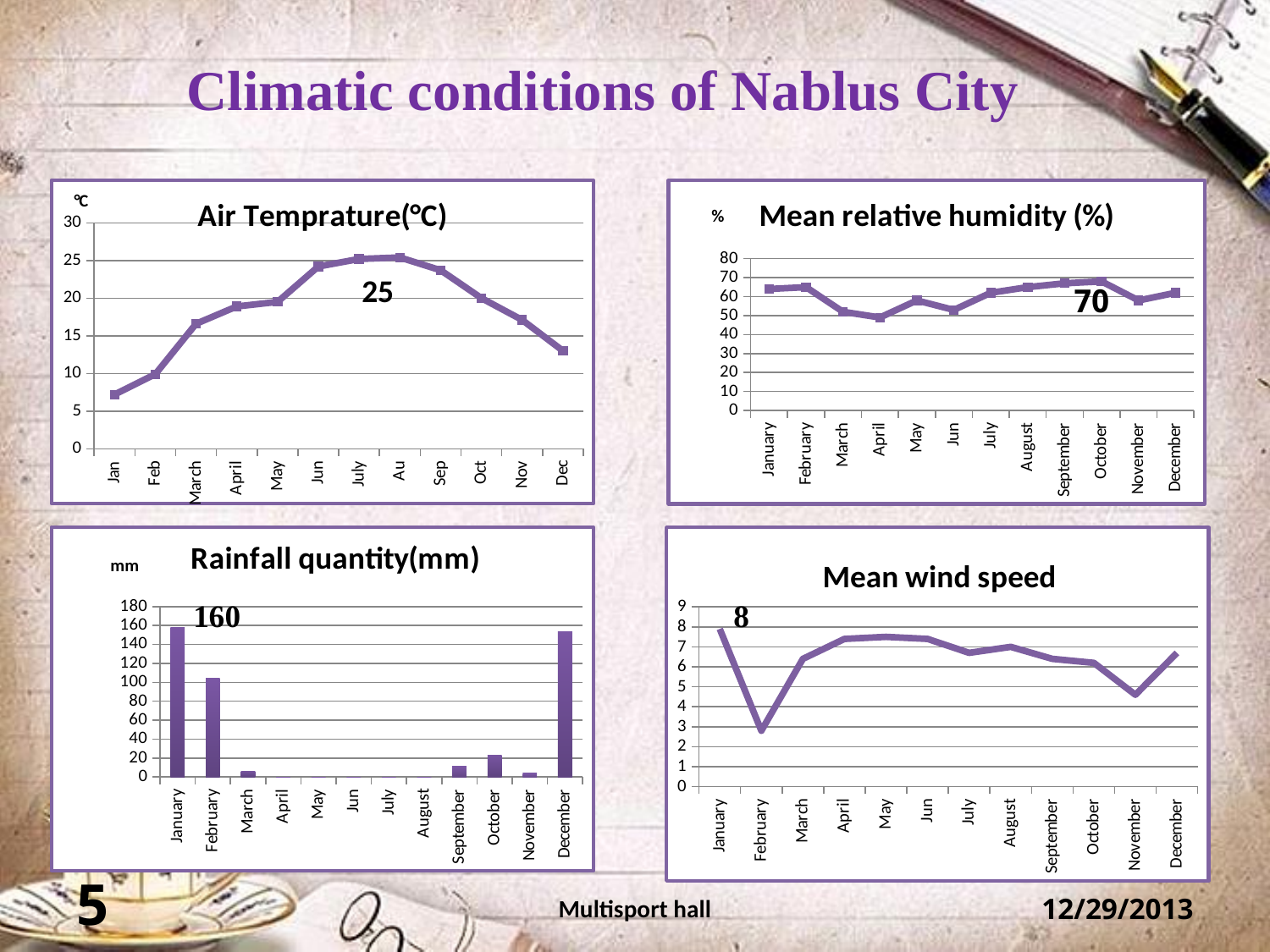
In the Air Temprature(°C) chart, is the value for Jun greater or less than 20? greater What kind of chart is the Rainfall quantity(mm) chart? bar chart What kind of chart is the Air Temprature(°C) chart? line chart In the Air Temprature(°C) chart, which month has the lowest temperature? Jan How many months are plotted on the Mean wind speed chart? 12 In the Rainfall quantity(mm) chart, is the value for January greater or less than 140? greater In the Mean relative humidity (%) chart, which month has the lowest humidity? April In the Air Temprature(°C) chart, is the value for Dec greater or less than 15? less In the Air Temprature(°C) chart, do the values rise or fall from Jan to Jun? rise In the Rainfall quantity(mm) chart, which is larger, the value for February or the value for October? February In the Mean wind speed chart, which month has the lowest wind speed? February